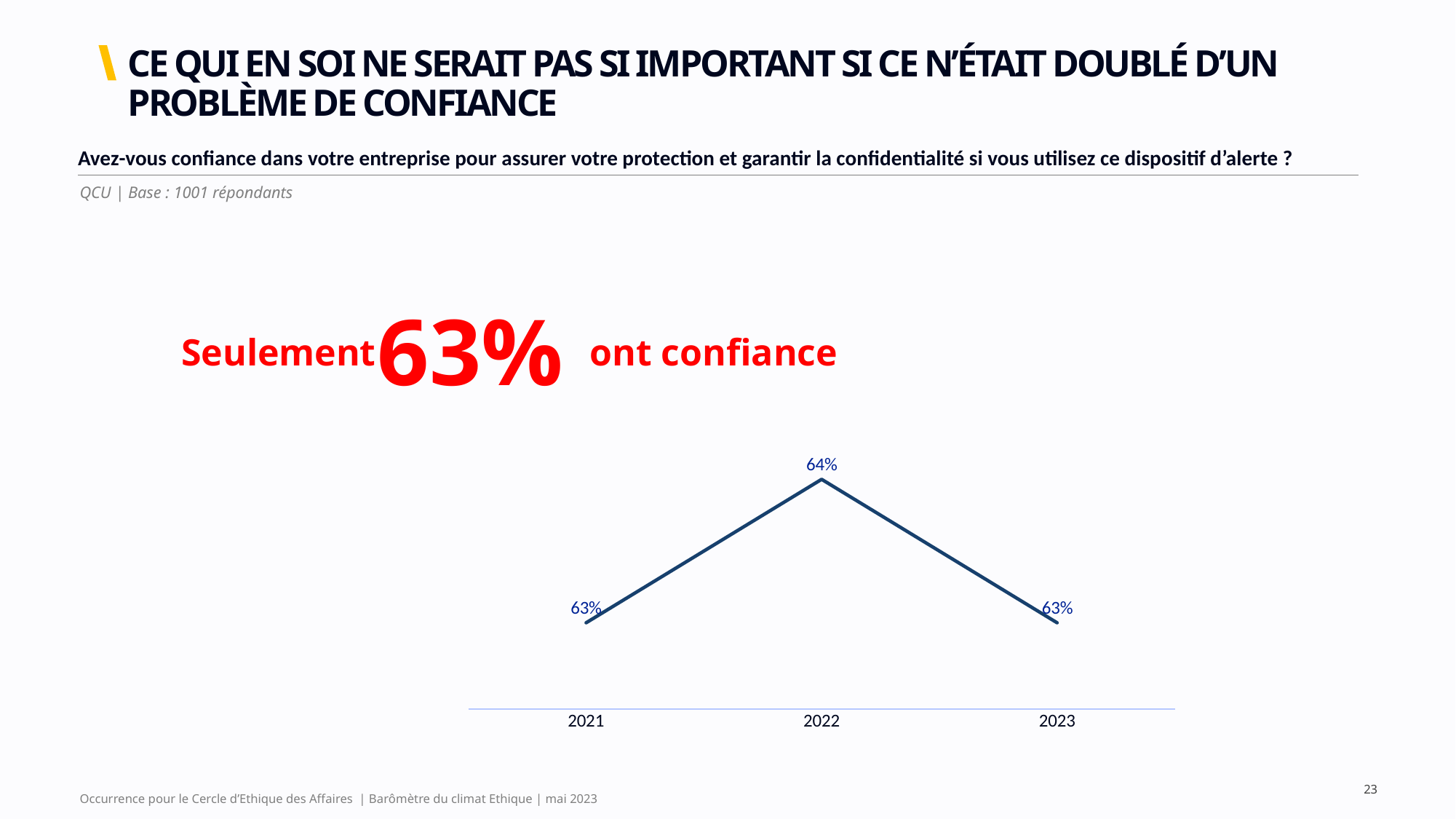
What is the difference between the values for 2022 and 2023? 1% What is the value for 2021? 63% How many years are plotted on the x axis? 3 What is the value for 2023? 63% What type of chart is shown on the slide? line chart Which is larger, the value for 2021 or the value for 2022? 2022 Which year has the highest value? 2022 Does the value rise or fall from 2021 to 2022? rise What is the first year shown on the x axis? 2021 Does the value rise or fall from 2022 to 2023? fall What is the value for 2022? 64% What percentage is highlighted in large red text above the chart? 63%